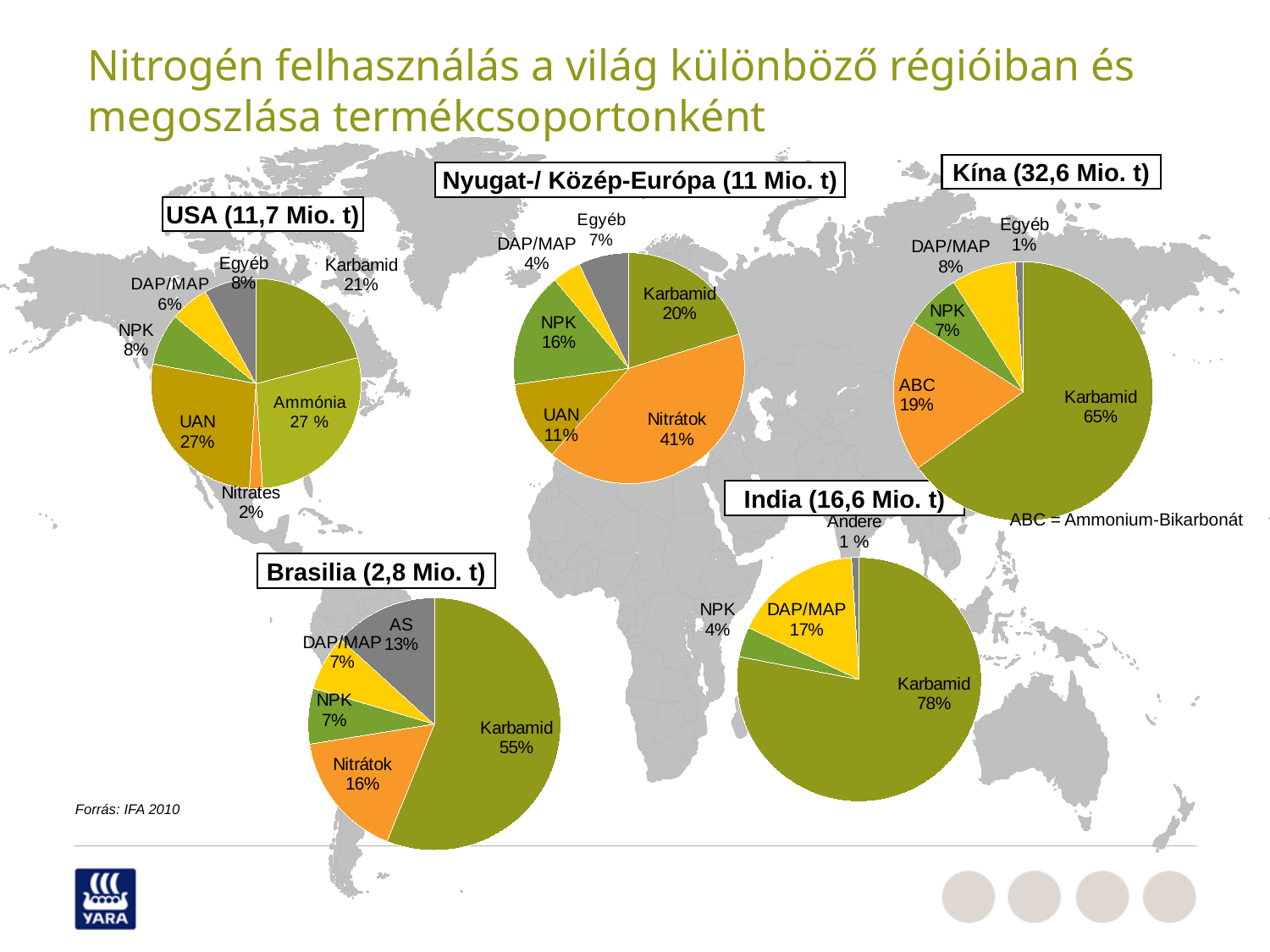
How many categories are shown in the India (16,6 Mio. t) pie chart? 4 In the USA (11,7 Mio. t) pie chart, which category has the smallest share? Nitrates How many pie charts are shown on the slide? 5 In the Kína (32,6 Mio. t) pie chart, which is larger: the ABC share or the NPK share? ABC How many categories are shown in the USA (11,7 Mio. t) pie chart? 7 In the India (16,6 Mio. t) pie chart, what share does DAP/MAP have? 17% In the USA (11,7 Mio. t) pie chart, what share does UAN have? 27% In the Nyugat-/Közép-Európa (11 Mio. t) pie chart, what share do Nitrátok have? 41% In the Brasilia (2,8 Mio. t) pie chart, which category has the largest share? Karbamid What kind of chart is used for each region on the slide? Pie chart In the Kína (32,6 Mio. t) pie chart, what share does Karbamid have? 65% In the Nyugat-/Közép-Európa (11 Mio. t) pie chart, how much larger is the Nitrátok share than the Karbamid share? 21 percentage points